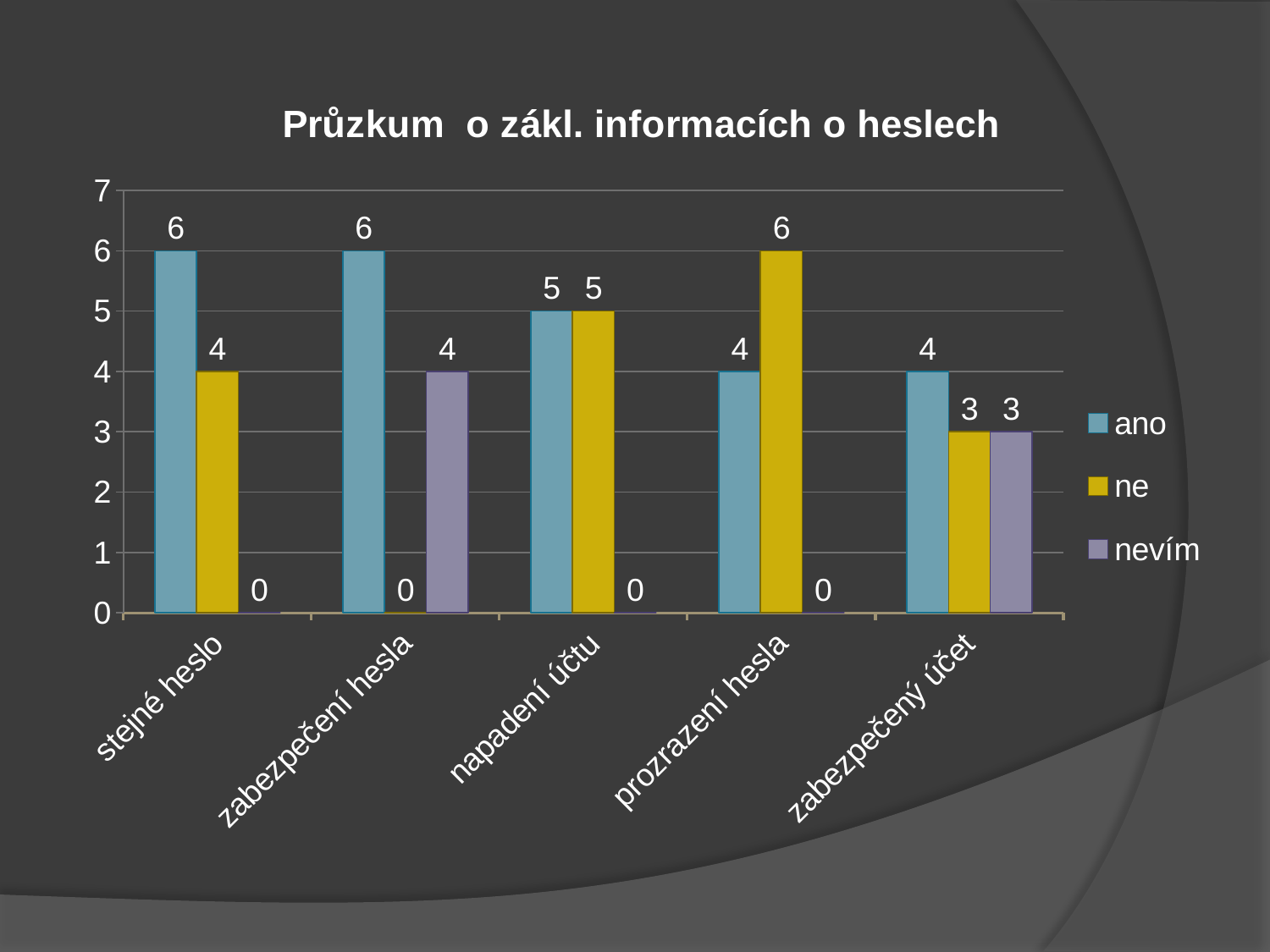
What is the value of the 'ne' series for 'zabezpečený účet'? 3 What is the value of the 'nevím' series for 'zabezpečení hesla'? 4 For 'prozrazení hesla', which is larger: the 'ano' value or the 'ne' value? ne Which category has the highest value for the 'ne' series? prozrazení hesla How many series does the legend list? 3 What is the value of the 'ano' series for 'stejné heslo'? 6 What is the title of the chart? Průzkum o zákl. informacích o heslech What is the value of the 'ne' series for 'prozrazení hesla'? 6 What is the difference between the 'ano' and 'ne' values for 'stejné heslo'? 2 What kind of chart is shown on the slide? bar chart Which category has the lowest value for the 'ano' series, among 'stejné heslo', 'zabezpečení hesla' and 'napadení účtu'? napadení účtu How many categories are shown on the x axis? 5